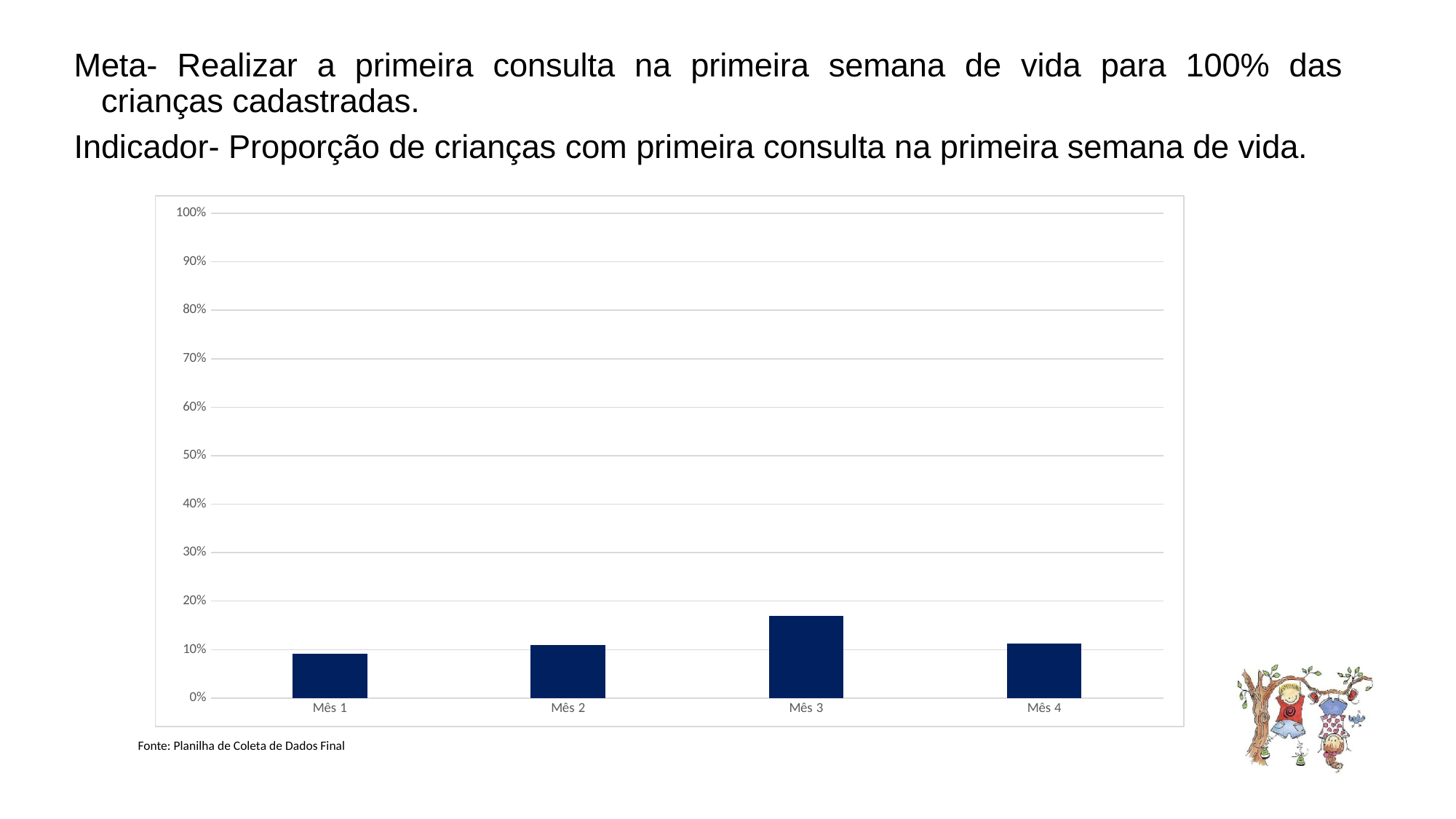
Is the value for Mês 3 greater or less than 10%? greater Which month has the highest value in the chart? Mês 3 Is the value for Mês 4 greater or less than 20%? less Is the value for Mês 1 greater or less than 10%? less How many categories (months) are shown on the x axis of the chart? 4 What is the highest value shown on the y axis of the chart? 100% Which is larger, the value for Mês 3 or the value for Mês 1? Mês 3 What source is cited below the chart? Planilha de Coleta de Dados Final Which month has the lowest value in the chart? Mês 1 What kind of chart is shown on the slide? bar chart Which is larger, the value for Mês 3 or the value for Mês 2? Mês 3